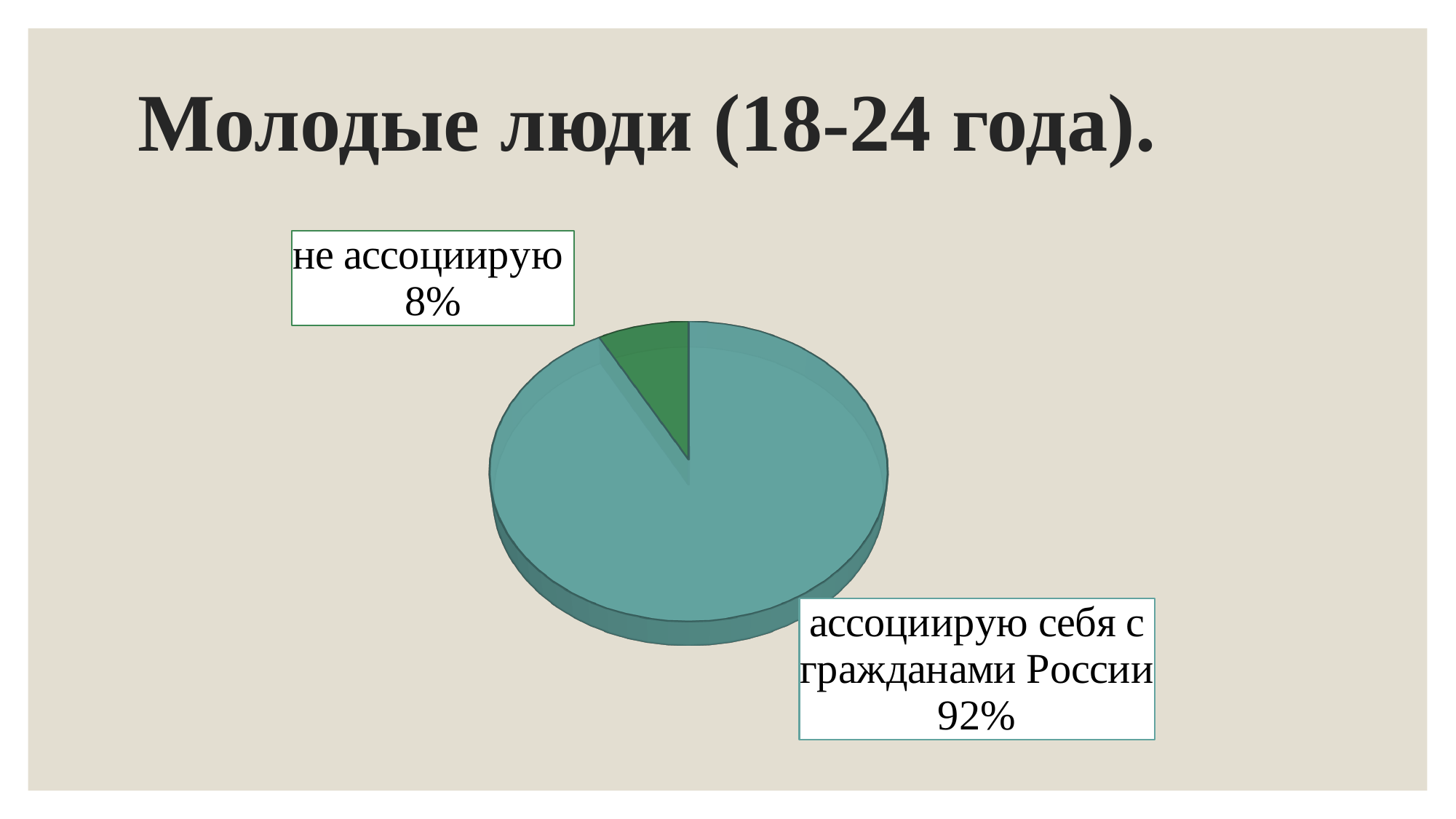
What is the title of the slide containing the pie chart? Молодые люди (18-24 года). What share of the pie is labelled "ассоциирую себя с гражданами России"? 92% Which slice of the pie is the smallest? не ассоциирую What share of the pie is labelled "не ассоциирую"? 8% Which slice of the pie is the largest? ассоциирую себя с гражданами России How many slices does the pie chart have? 2 What is the difference in percentage points between the "ассоциирую себя с гражданами России" slice and the "не ассоциирую" slice? 84 Which is larger: the "не ассоциирую" slice or the "ассоциирую себя с гражданами России" slice? ассоциирую себя с гражданами России What kind of chart is shown on the slide? pie chart What colour is the "не ассоциирую" slice of the pie? green